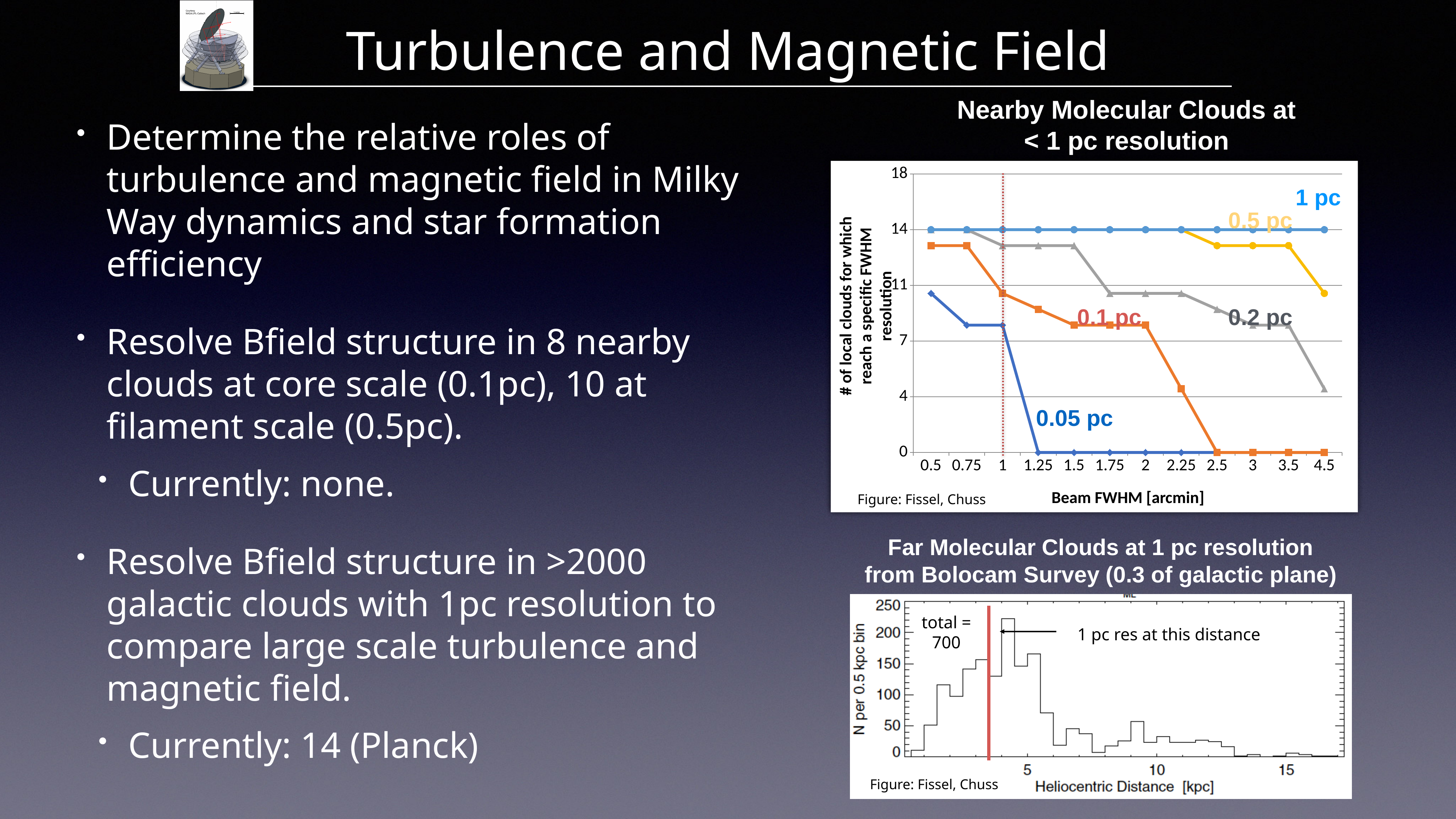
In the 'Nearby Molecular Clouds at < 1 pc resolution' chart, does the 0.2 pc series rise or fall as beam FWHM increases? fall In the 'Nearby Molecular Clouds at < 1 pc resolution' chart, is the value of the 0.05 pc series at 0.5 arcmin greater or less than 7? greater In the 'Nearby Molecular Clouds at < 1 pc resolution' chart, what is the value of the 1 pc series at a beam FWHM of 0.5 arcmin? 14 In the 'Nearby Molecular Clouds at < 1 pc resolution' chart, what is the value of the 0.05 pc series at a beam FWHM of 1.25 arcmin? 0 In the 'Nearby Molecular Clouds at < 1 pc resolution' chart, which is larger at a beam FWHM of 2.5 arcmin: the 1 pc series or the 0.1 pc series? 1 pc In the 'Nearby Molecular Clouds at < 1 pc resolution' chart, what is the value of the 0.1 pc series at a beam FWHM of 4.5 arcmin? 0 In the 'Nearby Molecular Clouds at < 1 pc resolution' chart, which series has the highest value at a beam FWHM of 4.5 arcmin? 1 pc In the 'Far Molecular Clouds at 1 pc resolution' chart, what total is annotated on the plot? 700 In the 'Nearby Molecular Clouds at < 1 pc resolution' chart, is the value of the 0.5 pc series at 4.5 arcmin greater or less than 14? less In the 'Nearby Molecular Clouds at < 1 pc resolution' chart, how many resolution series are labelled? 5 In the 'Nearby Molecular Clouds at < 1 pc resolution' chart, how many beam FWHM values are marked on the x axis? 12 In the 'Nearby Molecular Clouds at < 1 pc resolution' chart, what kind of chart is shown? line chart